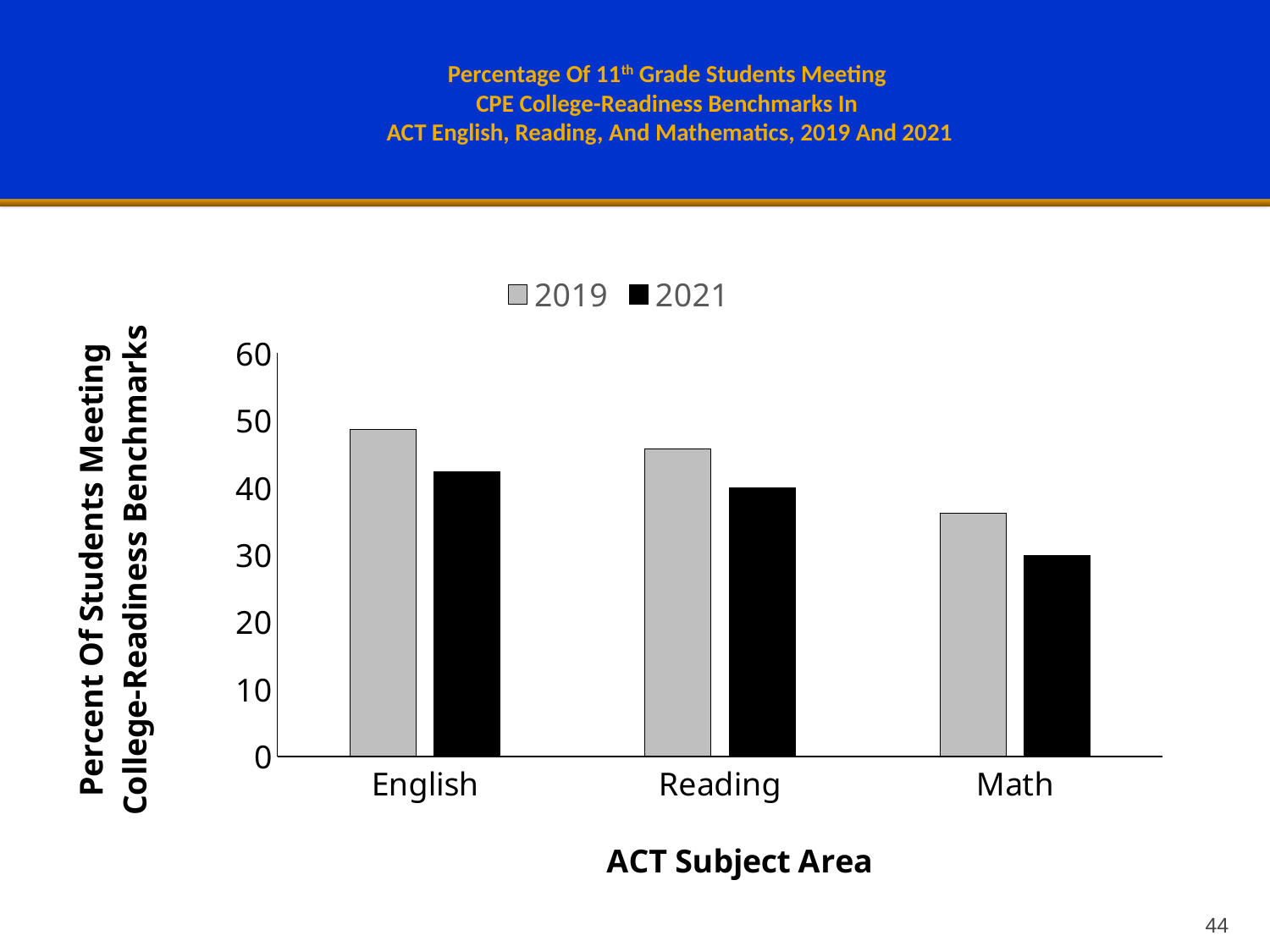
Which subject area has the lowest 2019 value? Math Is the 2019 value for Math greater or less than 40? less How many series does the legend list? 2 Is the 2021 value for Math greater or less than 40? less What kind of chart is shown on the slide? bar chart Do the 2021 values rise or fall moving from English to Math along the x axis? fall How many ACT subject areas are shown on the x axis? 3 Which subject area has the highest 2019 value? English For Reading, which year has the larger value, 2019 or 2021? 2019 What is the label of the x axis? ACT Subject Area Is the 2019 value for English greater or less than 40? greater Which subject area has the lowest 2021 value? Math